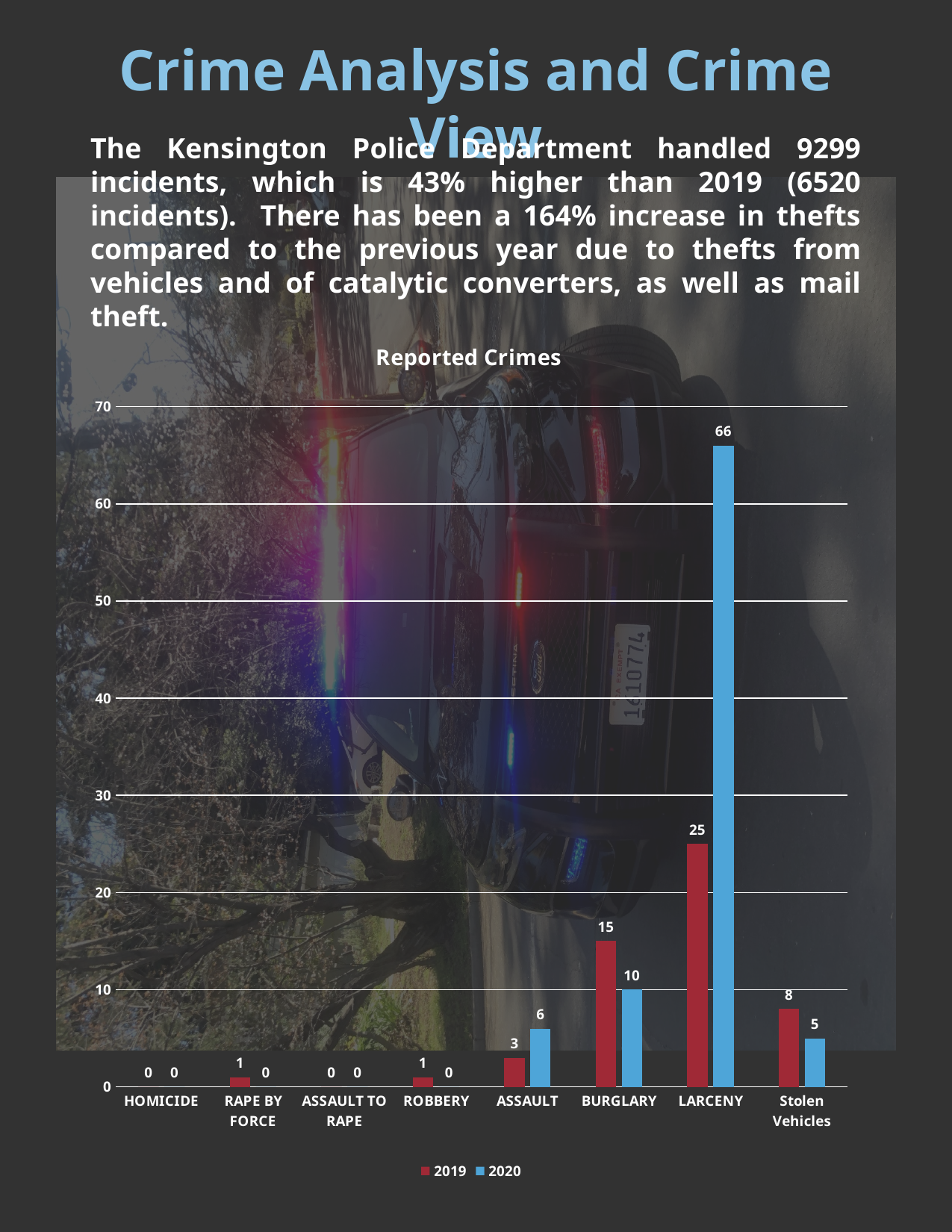
How many crime categories are shown on the x axis of the Reported Crimes chart? 8 Which category has the highest 2020 value in the Reported Crimes chart? LARCENY Is the 2020 value for LARCENY greater or less than 60? greater How many series does the legend of the Reported Crimes chart list? 2 What is the 2020 value for LARCENY in the Reported Crimes chart? 66 What is the 2019 value for ASSAULT in the Reported Crimes chart? 3 What is the 2020 value for Stolen Vehicles in the Reported Crimes chart? 5 What is the title of the chart on the slide? Reported Crimes What kind of chart is the Reported Crimes chart? bar chart Which is larger for BURGLARY: the 2019 value or the 2020 value? 2019 What is the difference between the 2020 and 2019 values for LARCENY? 41 What is the 2019 value for BURGLARY in the Reported Crimes chart? 15